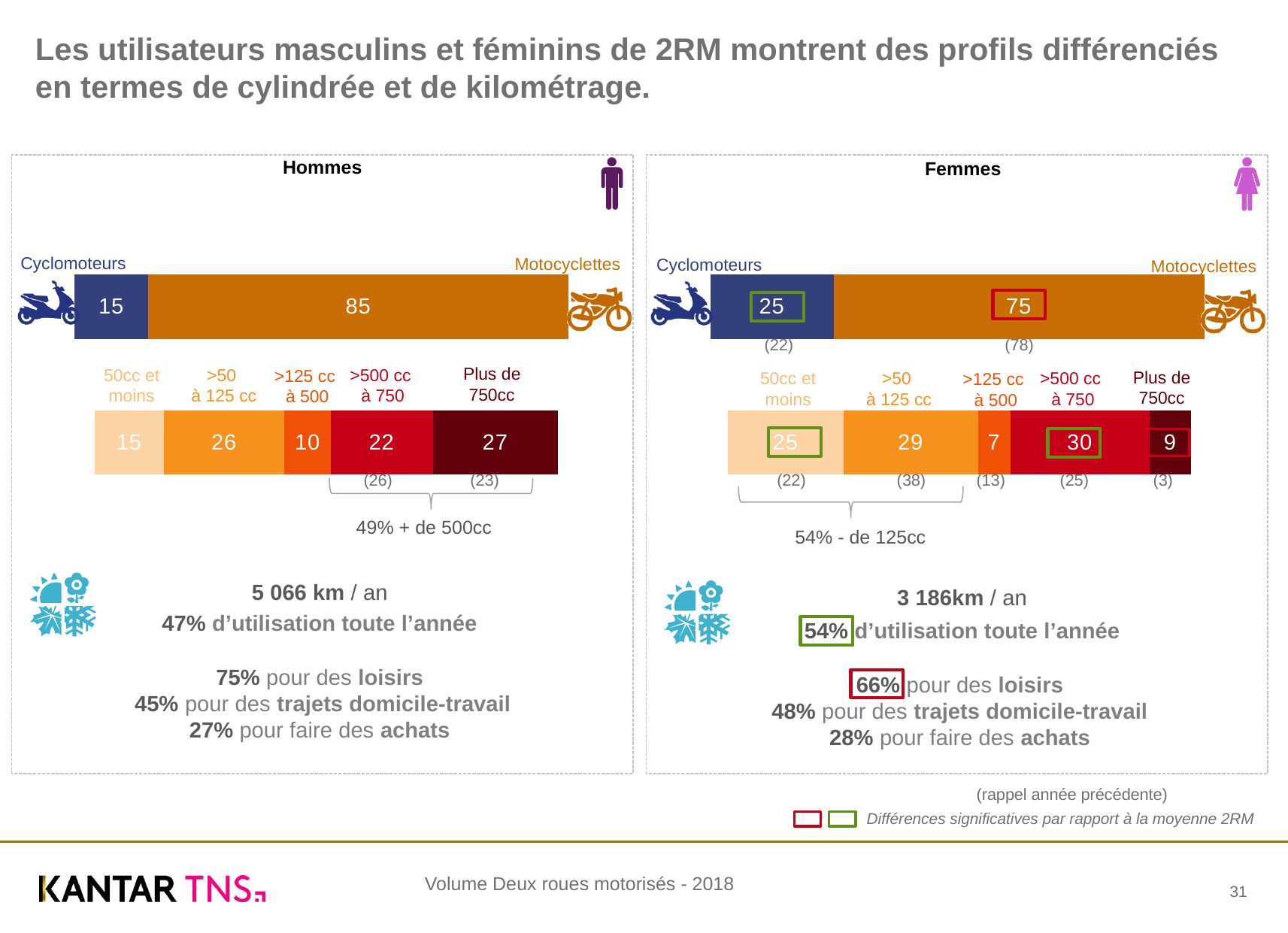
In the Femmes chart, what was the previous year's value (shown in parentheses) for '>50 à 125 cc'? (38) In the Femmes chart, what is the value for Motocyclettes? 75 In the Femmes engine-size bar, which category has the lowest value? >125 cc à 500 What kind of chart is used to show the Cyclomoteurs/Motocyclettes split for Hommes? Stacked bar chart In the Femmes engine-size bar, what is the value for '>125 cc à 500'? 7 In the Hommes engine-size bar, which category has the highest value? Plus de 750cc How many engine-size categories are shown in the Femmes engine-size bar? 5 In the Hommes engine-size bar, which is larger: '>50 à 125 cc' or '>500 cc à 750'? >50 à 125 cc What is the difference between the Motocyclettes values for Hommes and Femmes? 10 In the Hommes chart, what is the value for Cyclomoteurs? 15 In the Femmes engine-size bar, which category has the highest value? >500 cc à 750 In the Hommes engine-size bar, what is the value for '>500 cc à 750'? 22